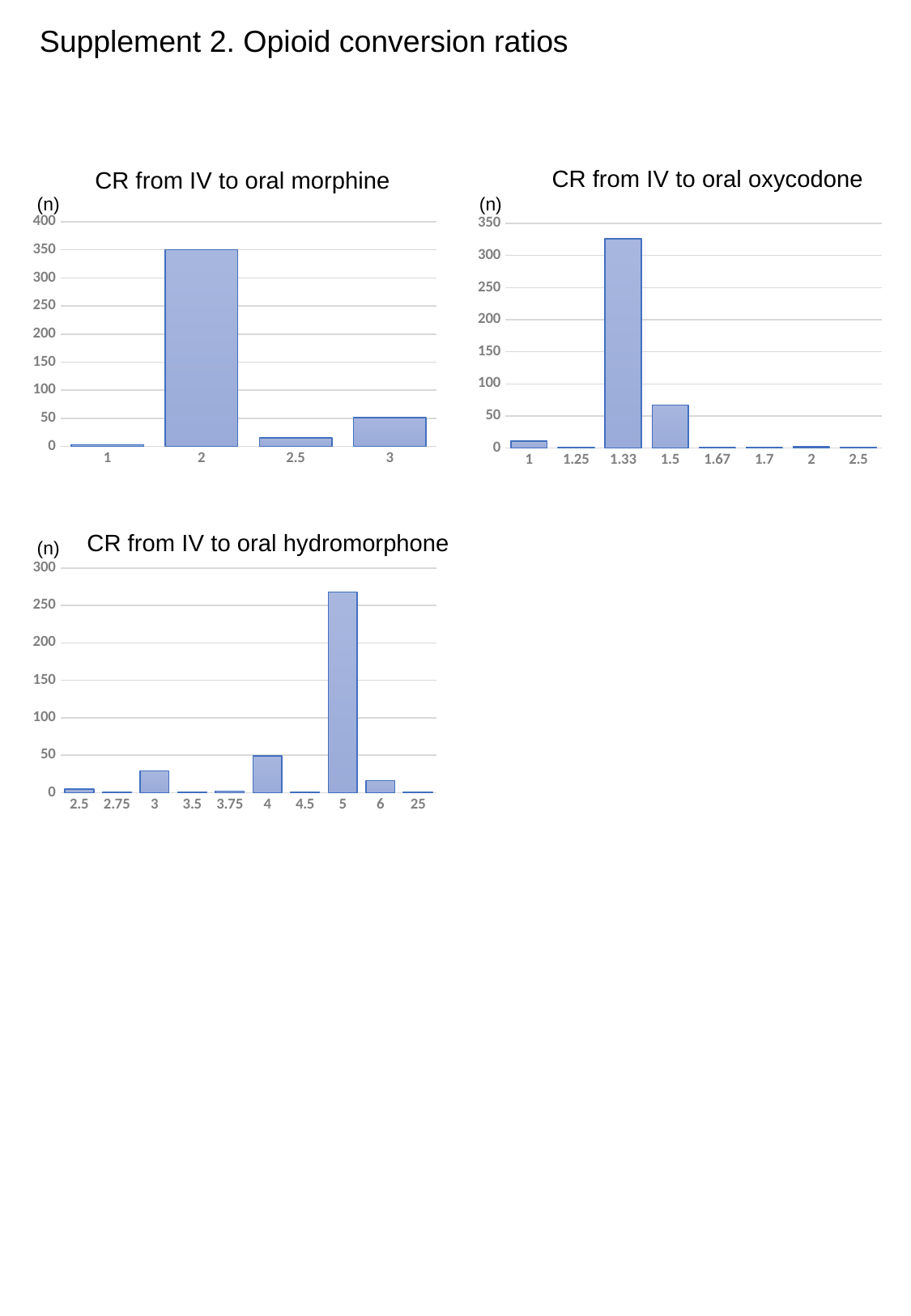
What type of chart is "CR from IV to oral hydromorphone"? Bar chart In the chart titled "CR from IV to oral hydromorphone", is the value for ratio 5 greater or less than 250? greater In the chart titled "CR from IV to oral morphine", is the value for ratio 3 greater or less than 100? less In the chart titled "CR from IV to oral morphine", how many conversion ratio categories are shown on the x axis? 4 In the chart titled "CR from IV to oral morphine", is the value for ratio 2 greater or less than 300? greater In the chart titled "CR from IV to oral hydromorphone", which conversion ratio has the highest count? 5 In the chart titled "CR from IV to oral hydromorphone", how many conversion ratio categories are shown on the x axis? 10 In the chart titled "CR from IV to oral oxycodone", which conversion ratio has the highest count? 1.33 In the chart titled "CR from IV to oral oxycodone", which is larger, the value for ratio 1 or the value for ratio 1.5? 1.5 In the chart titled "CR from IV to oral oxycodone", how many conversion ratio categories are shown on the x axis? 8 In the chart titled "CR from IV to oral morphine", which conversion ratio has the highest count? 2